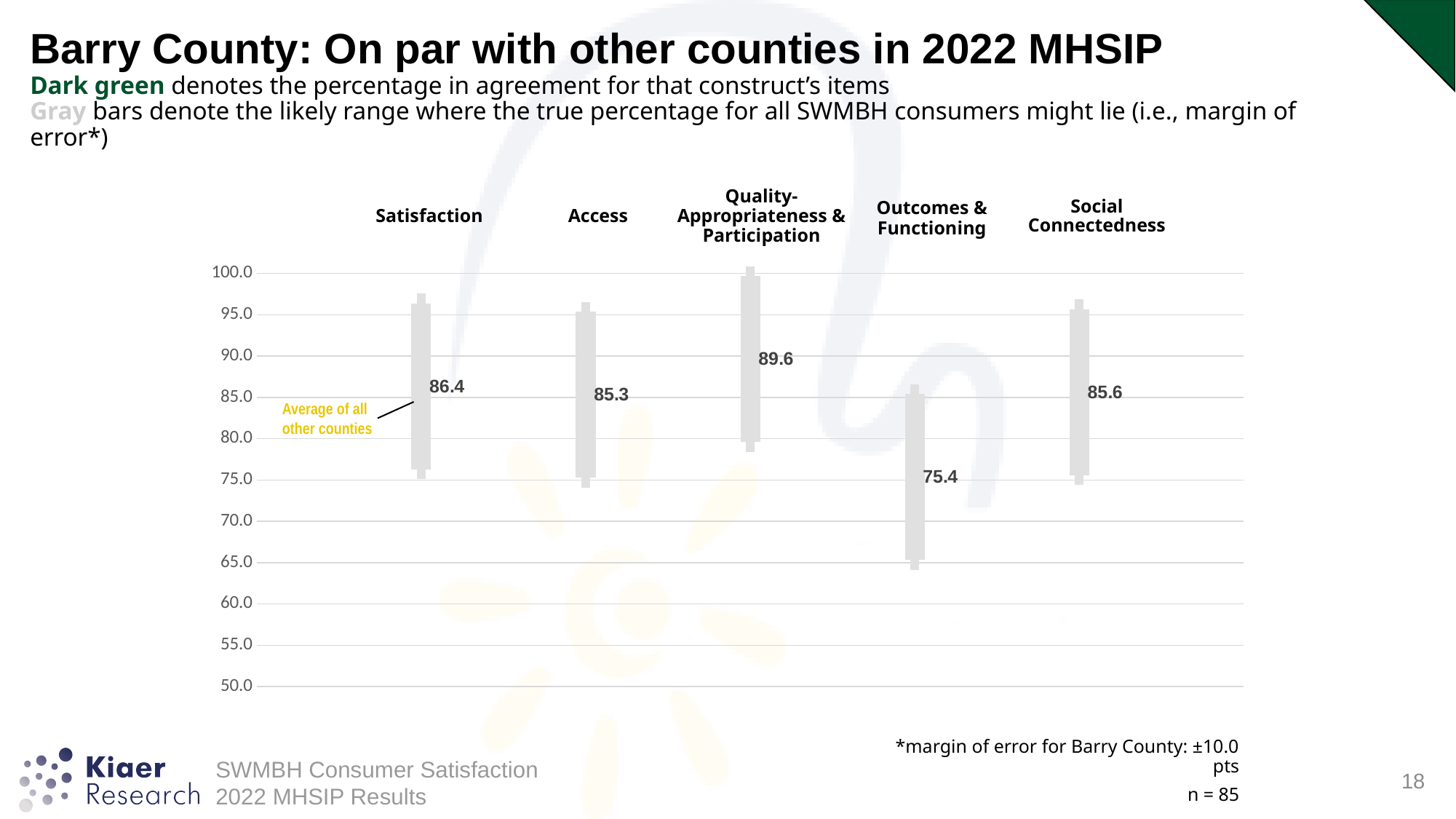
What is the value labeled for Social Connectedness? 85.6 How many constructs are shown on the chart? 5 What is the value labeled for Quality-Appropriateness & Participation? 89.6 What is the difference between the labeled values for Quality-Appropriateness & Participation and Outcomes & Functioning? 14.2 What is the value labeled for Satisfaction? 86.4 Which has a larger labeled value, Satisfaction or Access? Satisfaction Which construct has the lowest labeled value? Outcomes & Functioning What does the yellow annotation on the chart say the arrow points to? Average of all other counties Is the labeled value for Outcomes & Functioning greater or less than 80.0? less What is the value labeled for Outcomes & Functioning? 75.4 Which construct has the highest labeled value? Quality-Appropriateness & Participation What is the value labeled for Access? 85.3